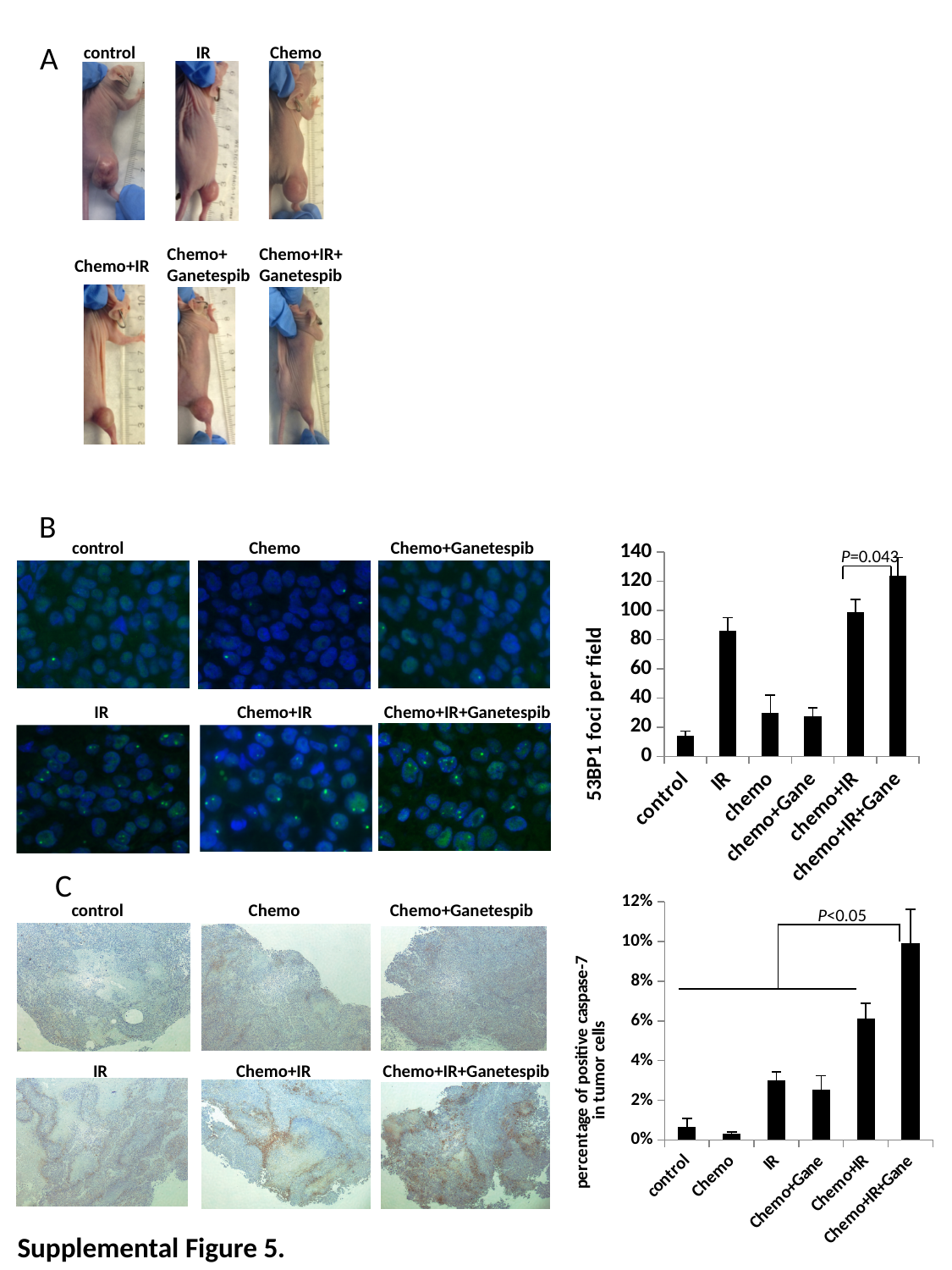
In the panel B chart (53BP1 foci per field), which category has the lowest value? control In the panel C chart (percentage of positive caspase-7 in tumor cells), which category has the highest value? Chemo+IR+Gane In the panel B chart (53BP1 foci per field), is the value for chemo greater or less than 60? less In the panel C chart (percentage of positive caspase-7 in tumor cells), which is larger, the value for IR or the value for control? IR In the panel C chart (percentage of positive caspase-7 in tumor cells), which category has the lowest value? Chemo What is the y-axis label of the panel C chart? percentage of positive caspase-7 in tumor cells In the panel B chart (53BP1 foci per field), which category has the highest value? chemo+IR+Gane In the panel B chart (53BP1 foci per field), which is larger, the value for chemo+IR or the value for chemo+Gane? chemo+IR What kind of chart is the panel B chart (53BP1 foci per field)? bar chart In the panel C chart (percentage of positive caspase-7 in tumor cells), is the value for Chemo+IR greater or less than 4%? greater How many categories are shown on the x axis of the panel B chart (53BP1 foci per field)? 6 In the panel B chart (53BP1 foci per field), is the value for IR greater or less than 60? greater